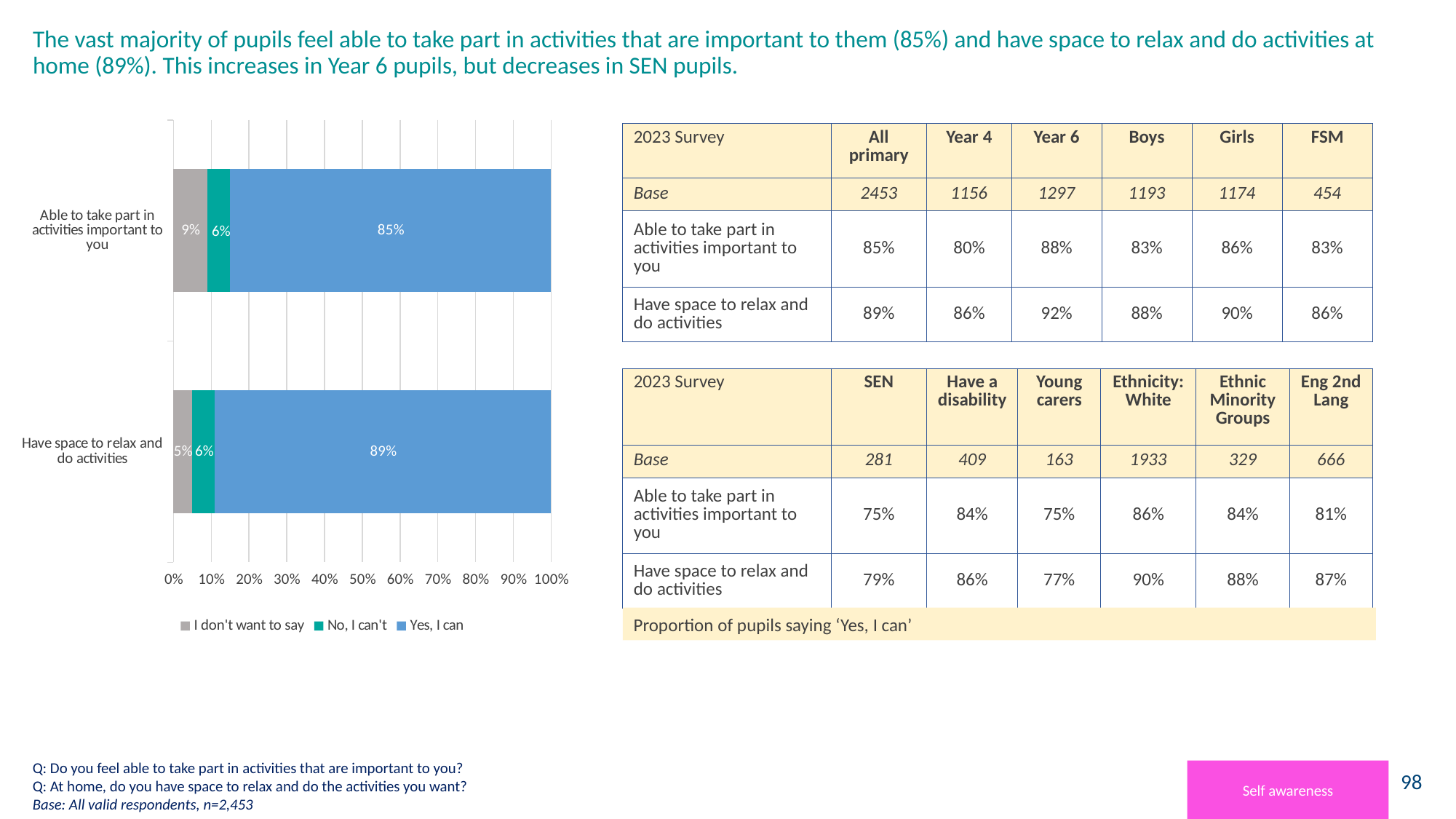
What is the 'No, I can't' value for 'Have space to relax and do activities'? 6% Which category has the higher 'Yes, I can' value? Have space to relax and do activities What is the 'Yes, I can' value for 'Have space to relax and do activities'? 89% How many categories does the bar chart show? 2 What is the difference between the 'Yes, I can' values for 'Have space to relax and do activities' and 'Able to take part in activities important to you'? 4% Is the 'I don't want to say' value larger for 'Able to take part in activities important to you' or for 'Have space to relax and do activities'? Able to take part in activities important to you How many series does the chart legend list? 3 What is the 'I don't want to say' value for 'Able to take part in activities important to you'? 9% What kind of chart is shown on the slide? Stacked bar chart What is the 'I don't want to say' value for 'Have space to relax and do activities'? 5% Which series in the legend is shown in blue? Yes, I can What is the 'Yes, I can' value for 'Able to take part in activities important to you'? 85%